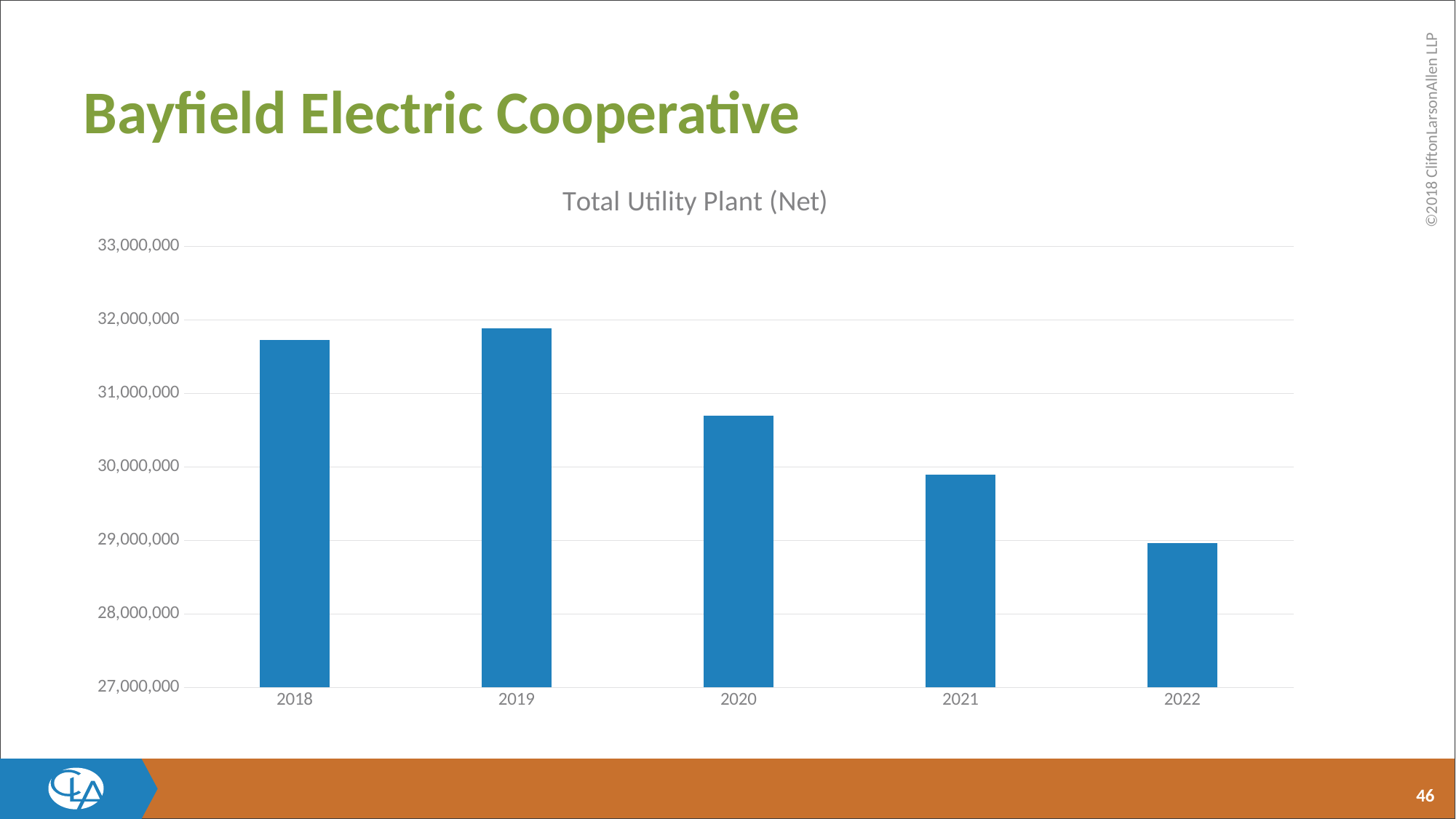
Is the value for 2021 greater or less than 29,000,000? greater How many years are shown on the x axis of the chart? 5 Is the value for 2022 greater or less than 28,000,000? greater What is the title of the chart? Total Utility Plant (Net) Which year has the lowest Total Utility Plant (Net)? 2022 Is the value for 2020 greater or less than 31,000,000? less Which is larger, the value for 2018 or the value for 2020? 2018 Do the values generally rise or fall from 2019 to 2022? fall Which year has the highest Total Utility Plant (Net)? 2019 What kind of chart is shown on the slide? bar chart